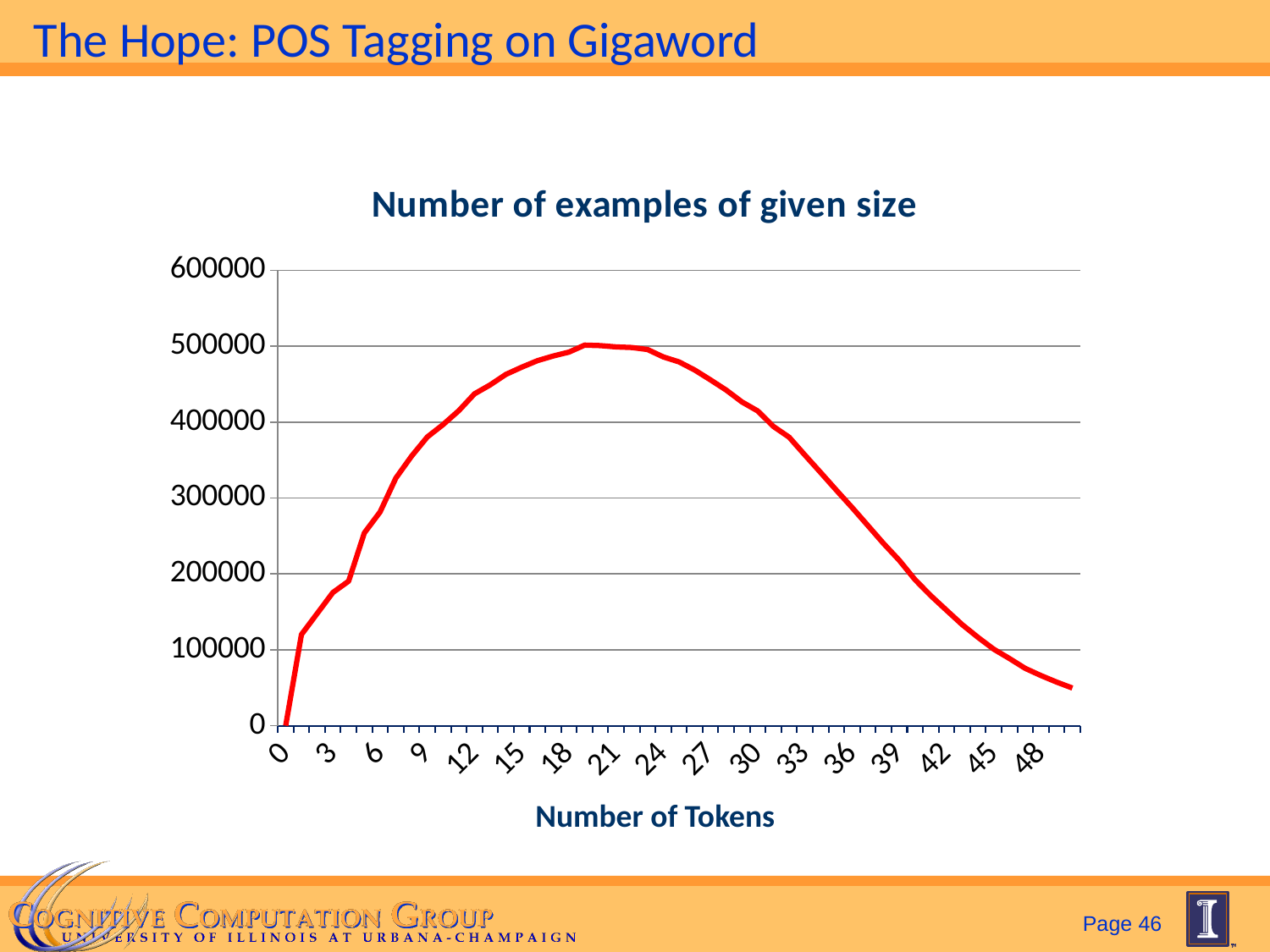
Is the value at 3 tokens greater or less than 200000? less Is the value at 48 tokens greater or less than 100000? less Is the value at 33 tokens greater or less than 400000? less Does the number of examples rise or fall as the number of tokens increases from 24 to 48? fall What is the title of the chart? Number of examples of given size What is the label of the x axis? Number of Tokens What kind of chart is shown on the slide? line chart Which has the larger value, 12 tokens or 42 tokens? 12 tokens How many tick labels are shown on the x axis? 17